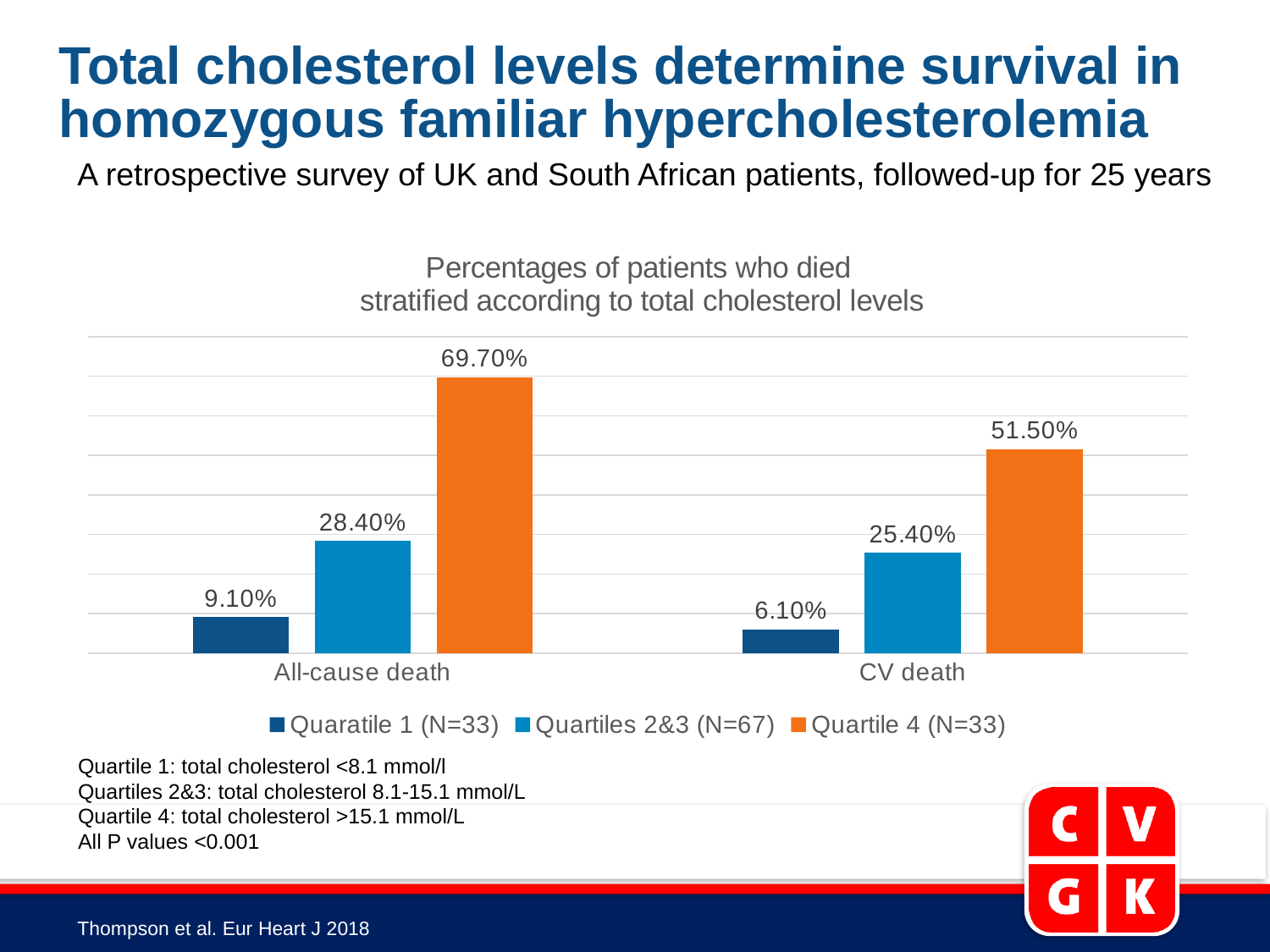
What is the title of the chart? Percentages of patients who died stratified according to total cholesterol levels What is the all-cause death percentage for Quaratile 1 (N=33)? 9.10% How many categories are shown on the x axis? 2 What percentage of Quartile 4 (N=33) patients had all-cause death? 69.70% What kind of chart is shown on the slide? Bar chart How many series does the legend list? 3 Which series has the highest CV death percentage? Quartile 4 (N=33) What is the CV death percentage for Quartiles 2&3 (N=67)? 25.40% Which series has the lowest all-cause death percentage? Quaratile 1 (N=33) Which is larger: the CV death percentage for Quartiles 2&3 (N=67) or the all-cause death percentage for Quaratile 1 (N=33)? CV death for Quartiles 2&3 (N=67) What is the difference between the all-cause death percentages of Quartiles 2&3 (N=67) and Quaratile 1 (N=33)? 19.30% What is the difference between the all-cause death and CV death percentages for Quartile 4 (N=33)? 18.20%